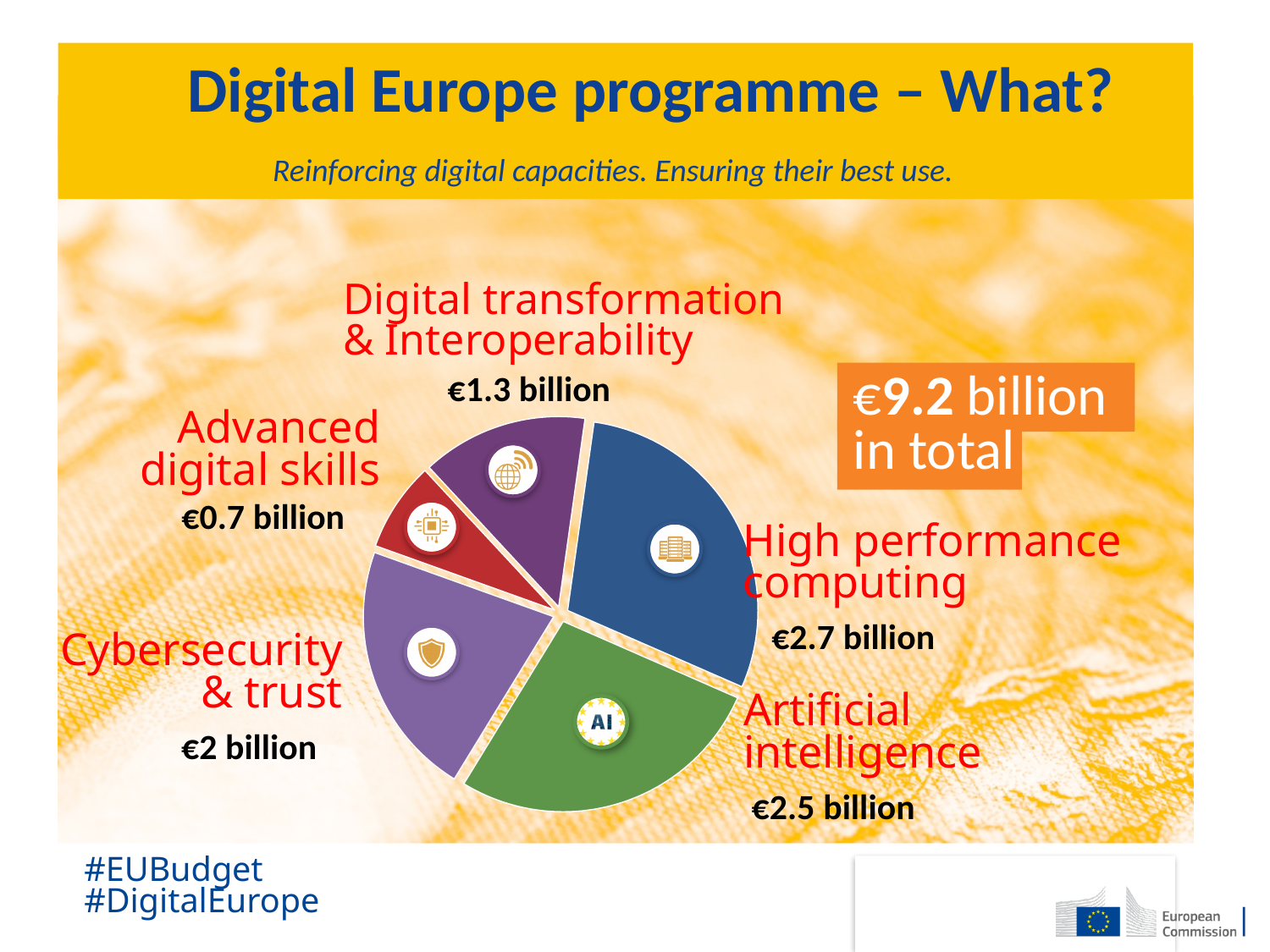
What kind of chart is shown on the slide? Pie chart Which is larger, the value for Cybersecurity & trust or the value for Digital transformation & Interoperability? Cybersecurity & trust What is the value for Digital transformation & Interoperability? €1.3 billion Which category has the smallest slice of the pie? Advanced digital skills What is the value for High performance computing? €2.7 billion What is the value for Artificial intelligence? €2.5 billion Which category has the largest slice of the pie? High performance computing What total amount does the slide state for the programme? €9.2 billion What is the value for Cybersecurity & trust? €2 billion What is the value for Advanced digital skills? €0.7 billion What is the difference between the values for High performance computing and Artificial intelligence? €0.2 billion How many slices does the pie chart have? 5